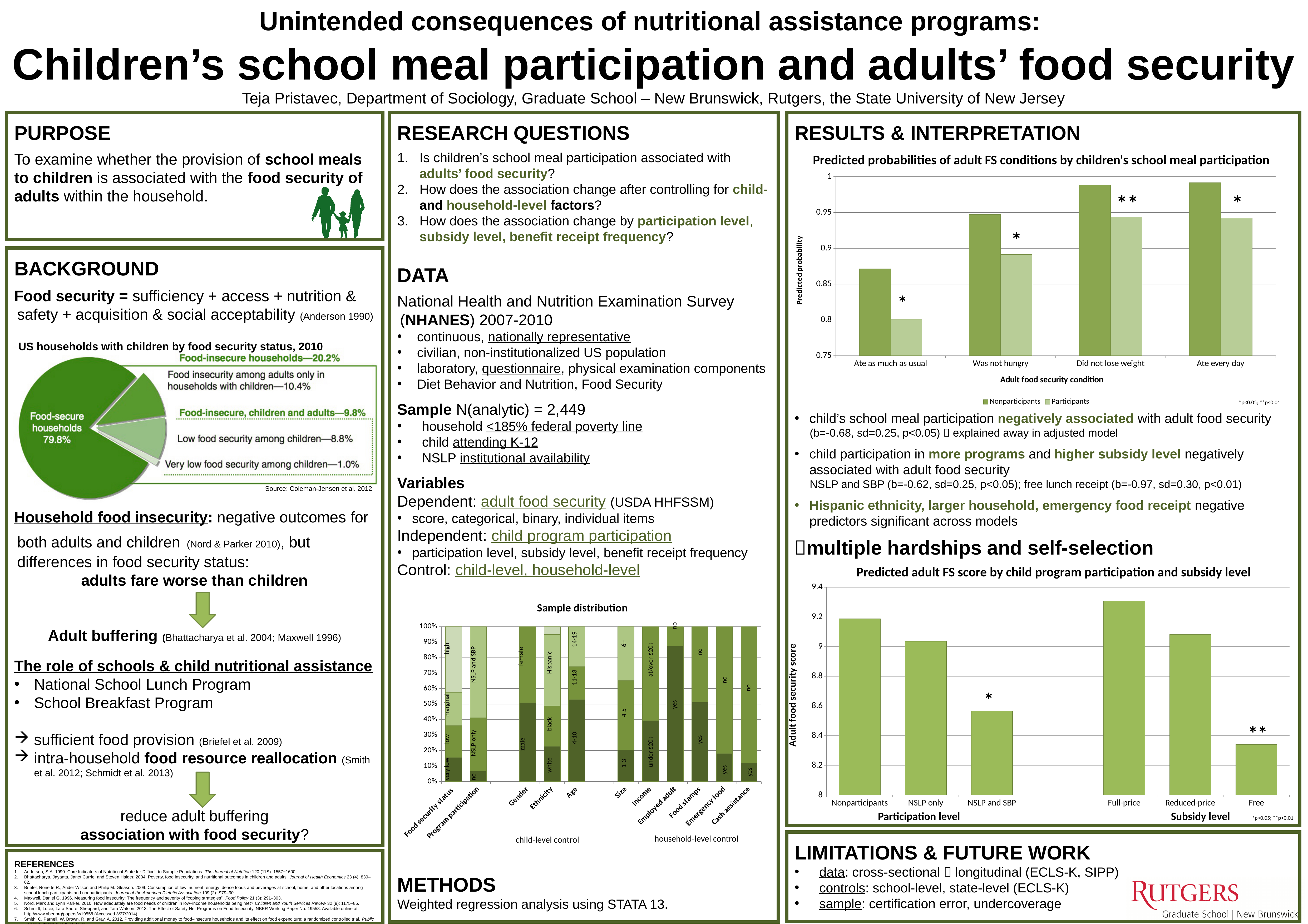
In the chart 'Predicted adult FS score by child program participation and subsidy level', which category has the lowest predicted score? Free What kind of chart is the 'Sample distribution' chart? Stacked bar chart In the pie chart 'US households with children by food security status, 2010', what share of households are food-secure? 79.8% In the chart 'Predicted adult FS score by child program participation and subsidy level', is the value for Free greater or less than 8.4? less In the chart 'Predicted probabilities of adult FS conditions by children's school meal participation', which is larger for 'Ate as much as usual': Nonparticipants or Participants? Nonparticipants In the pie chart 'US households with children by food security status, 2010', what is the percentage for very low food security among children? 1.0% In the chart 'Predicted probabilities of adult FS conditions by children's school meal participation', is the Participants value for 'Ate as much as usual' greater or less than 0.85? less In the chart 'Predicted probabilities of adult FS conditions by children's school meal participation', how many series does the legend list? 2 In the chart 'Predicted probabilities of adult FS conditions by children's school meal participation', which condition has the lowest Participants value? Ate as much as usual In the pie chart 'US households with children by food security status, 2010', what percentage of households are food-insecure? 20.2% In the chart 'Predicted probabilities of adult FS conditions by children's school meal participation', how many adult food security conditions are shown on the x axis? 4 In the chart 'Predicted adult FS score by child program participation and subsidy level', which category has the highest predicted score? Full-price